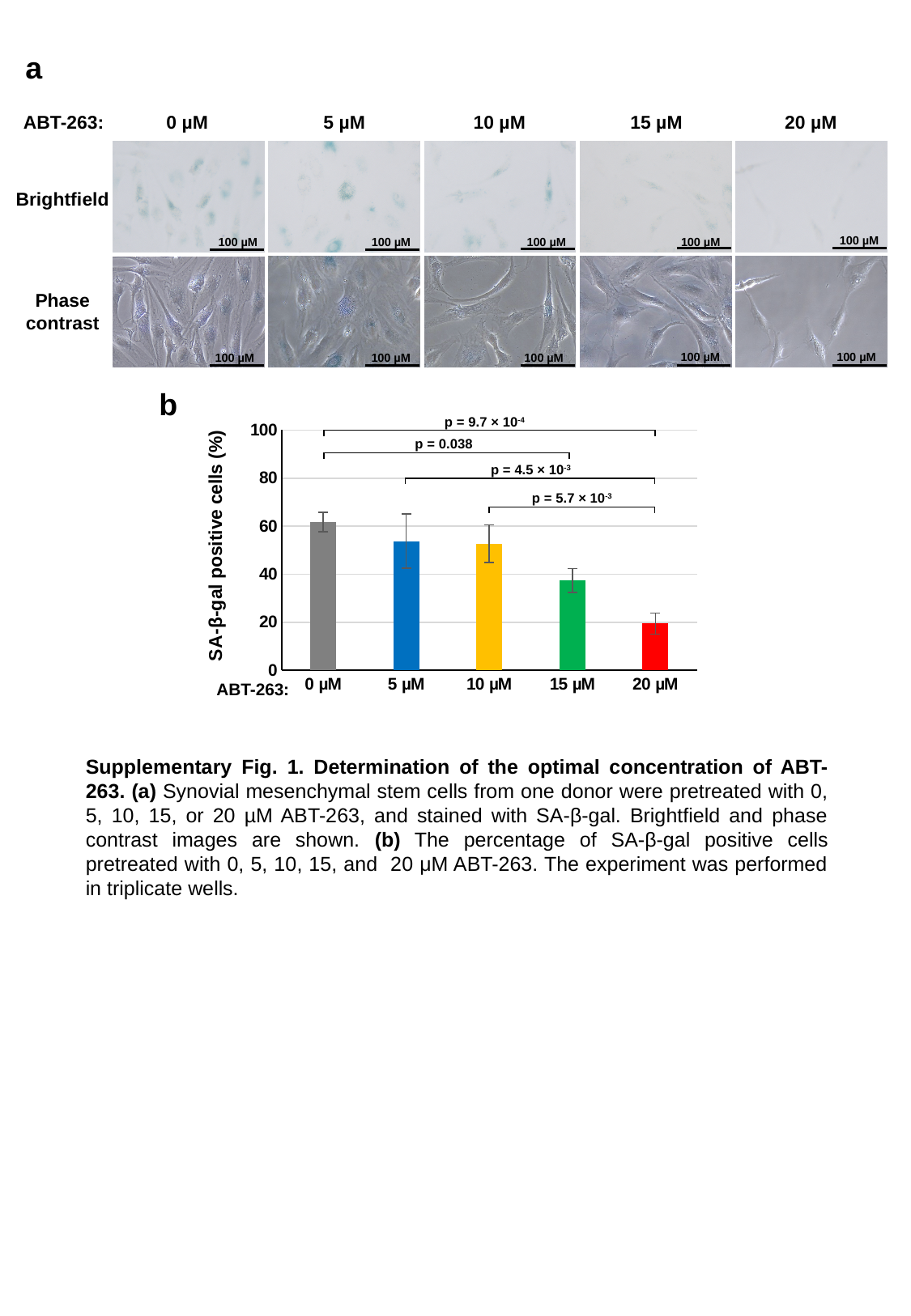
In the chart in panel b, which ABT-263 concentration has the lowest percentage of SA-β-gal positive cells? 20 µM In the chart in panel b, what is the label of the y axis? SA-β-gal positive cells (%) In the chart in panel b, is the value for 20 µM greater or less than 40? less In the chart in panel b, is the value for 0 µM greater or less than 40? greater What kind of chart is shown in panel b? bar chart In the chart in panel b, what p value is shown for the comparison between 0 µM and 20 µM? p = 9.7 × 10⁻⁴ In the chart in panel b, is the percentage of SA-β-gal positive cells higher at 0 µM or at 15 µM ABT-263? 0 µM In the chart in panel b, which ABT-263 concentration has the highest percentage of SA-β-gal positive cells? 0 µM In the chart in panel b, do the values rise or fall as the ABT-263 concentration increases along the x axis? fall In the chart in panel b, how many ABT-263 concentrations are plotted on the x axis? 5 In the chart in panel b, is the value for 10 µM greater or less than 40? greater In the chart in panel b, is the percentage of SA-β-gal positive cells higher at 15 µM or at 20 µM ABT-263? 15 µM